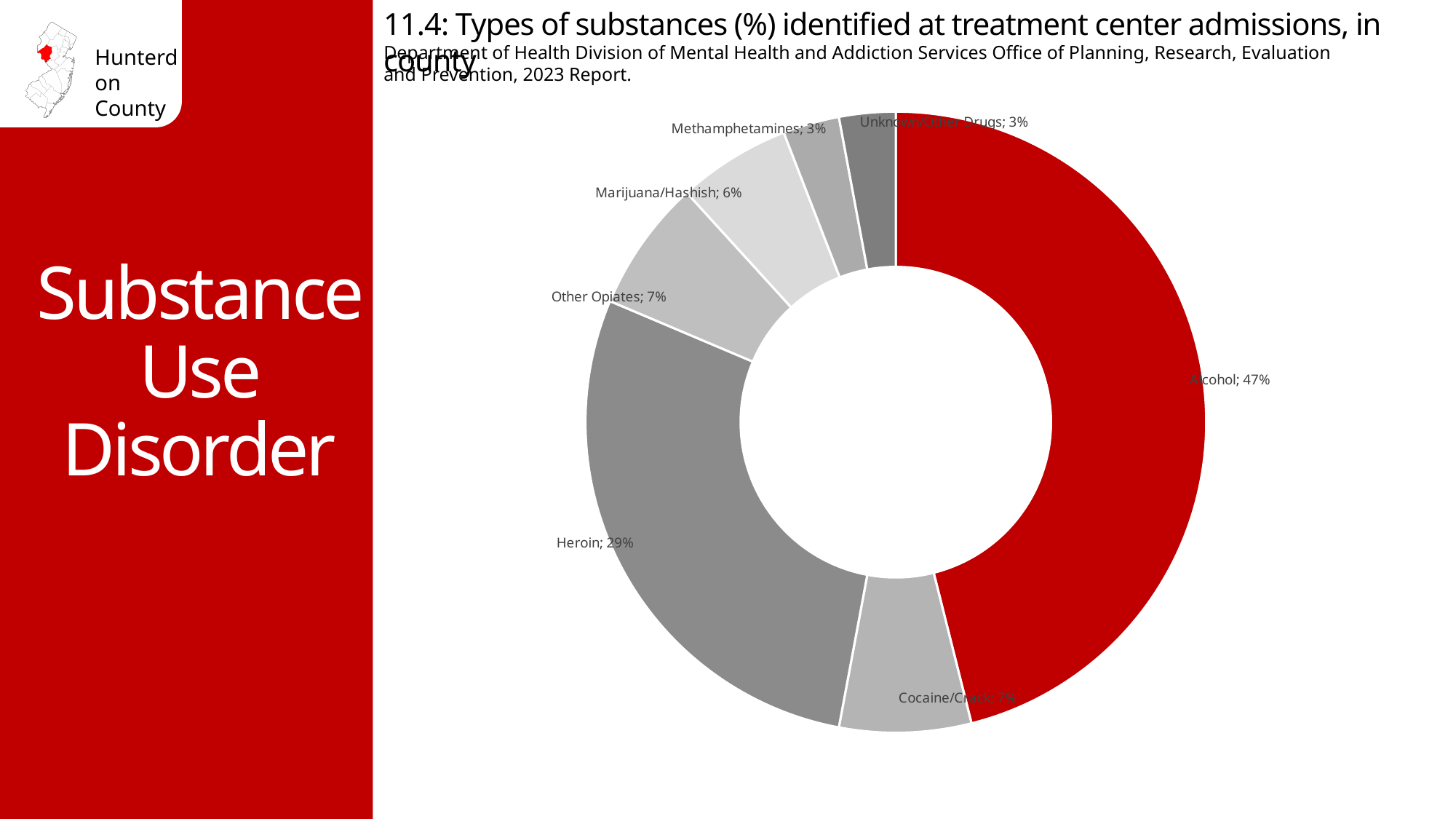
Which substance has the largest share of admissions? Alcohol What percentage is shown for Other Opiates? 7% What percentage of treatment center admissions is attributed to Alcohol? 47% What is the combined percentage for Methamphetamines and Unknown/Other Drugs? 6% What percentage is shown for Cocaine/Crack? 7% Which is larger, the share for Heroin or the share for Cocaine/Crack? Heroin What percentage is shown for Heroin? 29% What is the difference in percentage points between Alcohol and Heroin? 18 What kind of chart is shown on the slide? Pie (doughnut) chart What percentage is shown for Marijuana/Hashish? 6% How many substance categories are shown in the chart? 7 Which slice of the chart is coloured red? Alcohol